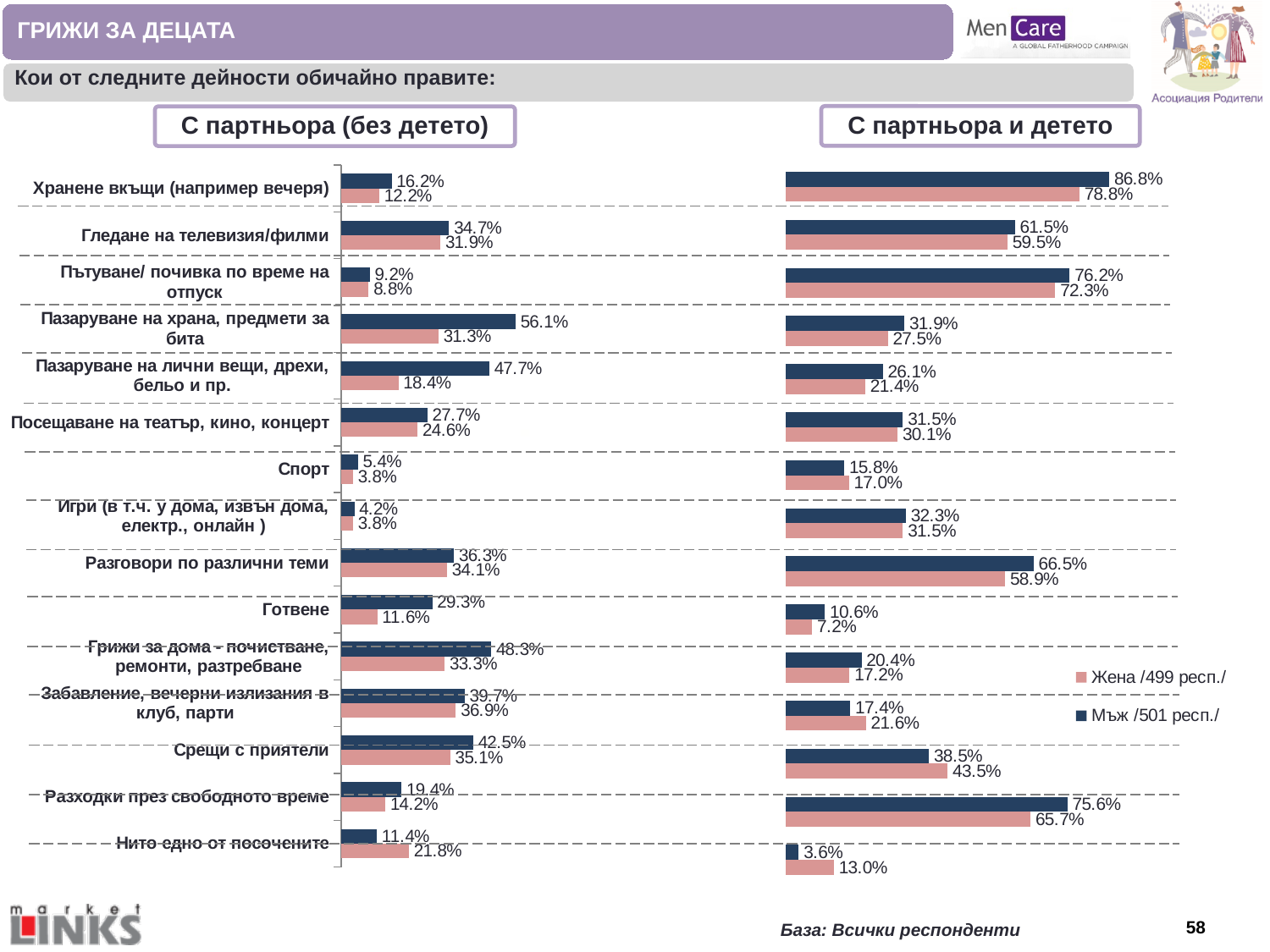
In the chart 'С партньора (без детето)', what is the difference between the Мъж and Жена values for 'Пазаруване на лични вещи, дрехи, бельо и пр.'? 29.3% How many series does the legend list? 2 In the chart 'С партньора (без детето)', what is the difference between the Мъж and Жена values for 'Готвене'? 17.7% In the chart 'С партньора и детето', what is the value for Жена for 'Хранене вкъщи (например вечеря)'? 78.8% In the chart 'С партньора и детето', which category has the highest value for Мъж? Хранене вкъщи (например вечеря) How many categories are shown in the chart 'С партньора (без детето)'? 15 Which series is shown in pink in the legend? Жена /499 респ./ In the chart 'С партньора и детето', which is larger for 'Срещи с приятели': the Мъж value or the Жена value? Жена (43.5%) In the chart 'С партньора (без детето)', which category has the lowest value for Жена? Спорт / Игри (в т.ч. у дома, извън дома, електр., онлайн ) (both 3.8%) What kind of chart is 'С партньора и детето'? Bar chart In the chart 'С партньора и детето', what is the value for Мъж for 'Нито едно от посочените'? 3.6% In the chart 'С партньора (без детето)', what is the value for Мъж for 'Пазаруване на храна, предмети за бита'? 56.1%